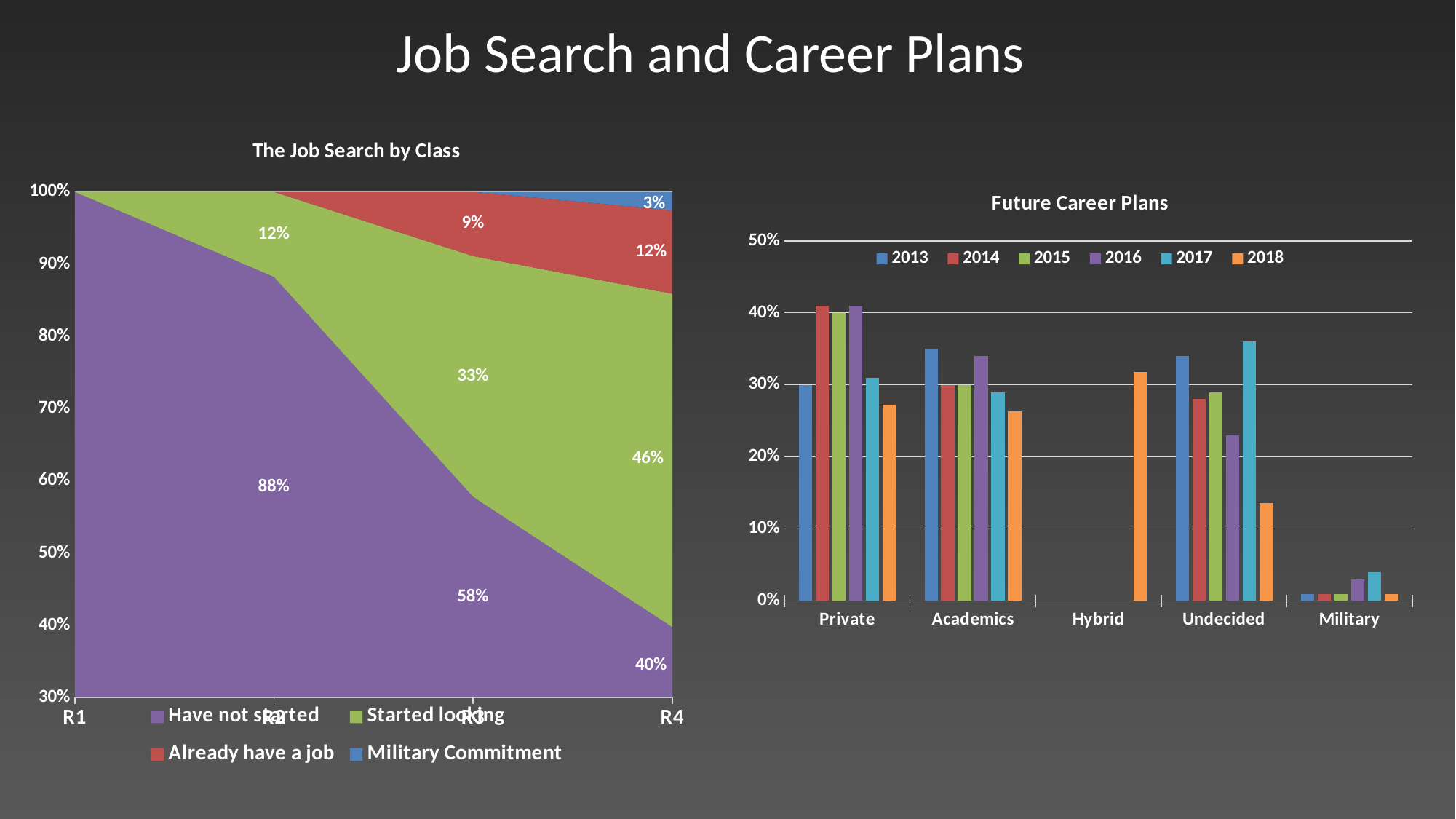
In the chart 'The Job Search by Class', by how many percentage points does 'Have not started' drop from R2 to R3? 30 percentage points In the chart 'The Job Search by Class', what is the Military Commitment value for R4? 3% In 'Future Career Plans', which year has the taller bar for Undecided, 2017 or 2018? 2017 In the chart 'The Job Search by Class', what percentage of R3 had not started the job search? 58% In the chart 'The Job Search by Class', does the 'Have not started' share rise or fall from R1 to R4? fall How many career categories are shown on the x axis of 'Future Career Plans'? 5 In 'Future Career Plans', is the 2018 value for Undecided greater or less than 20%? less In the chart 'The Job Search by Class', what is the 'Already have a job' value for R3? 9% What kind of chart is 'Future Career Plans'? bar chart How many series does the legend of 'The Job Search by Class' list? 4 In the chart 'The Job Search by Class', what percentage of R4 had started looking? 46% How many years does the legend of 'Future Career Plans' list? 6